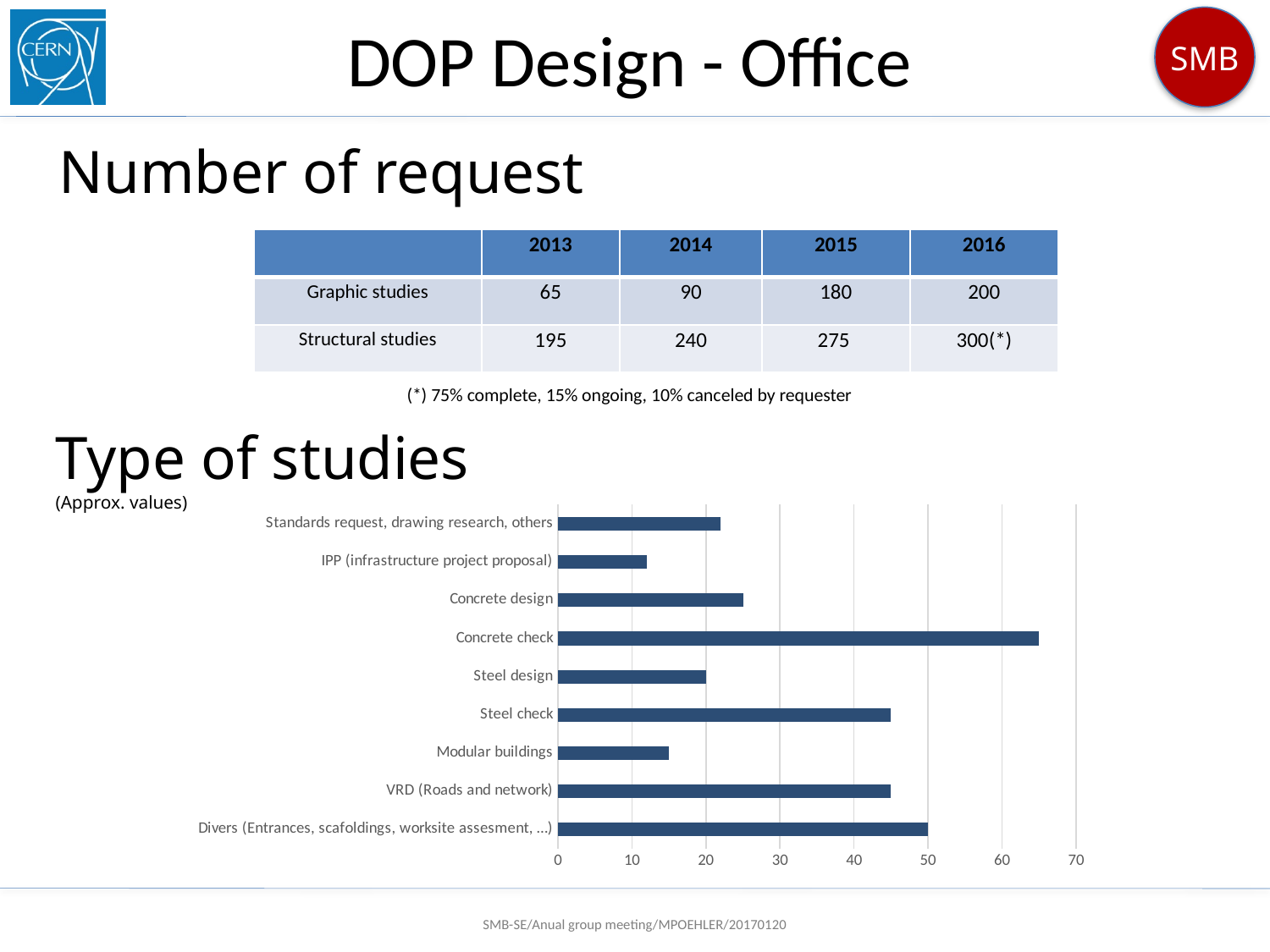
In the "Type of studies" chart, is the value for Modular buildings greater or less than 20? less How many categories are plotted in the "Type of studies" chart? 9 In the "Type of studies" chart, which is larger: Divers (Entrances, scafoldings, worksite assesment, ...) or Modular buildings? Divers (Entrances, scafoldings, worksite assesment, ...) Which category has the highest value in the "Type of studies" chart? Concrete check In the "Type of studies" chart, is the value for Steel check greater or less than 50? less What kind of chart is shown under "Type of studies"? bar chart In the "Type of studies" chart, is the value for Concrete check greater or less than 60? greater What is the highest value shown on the x axis of the "Type of studies" chart? 70 In the "Type of studies" chart, which is larger: Concrete check or Steel check? Concrete check Which category has the lowest value in the "Type of studies" chart? IPP (infrastructure project proposal)